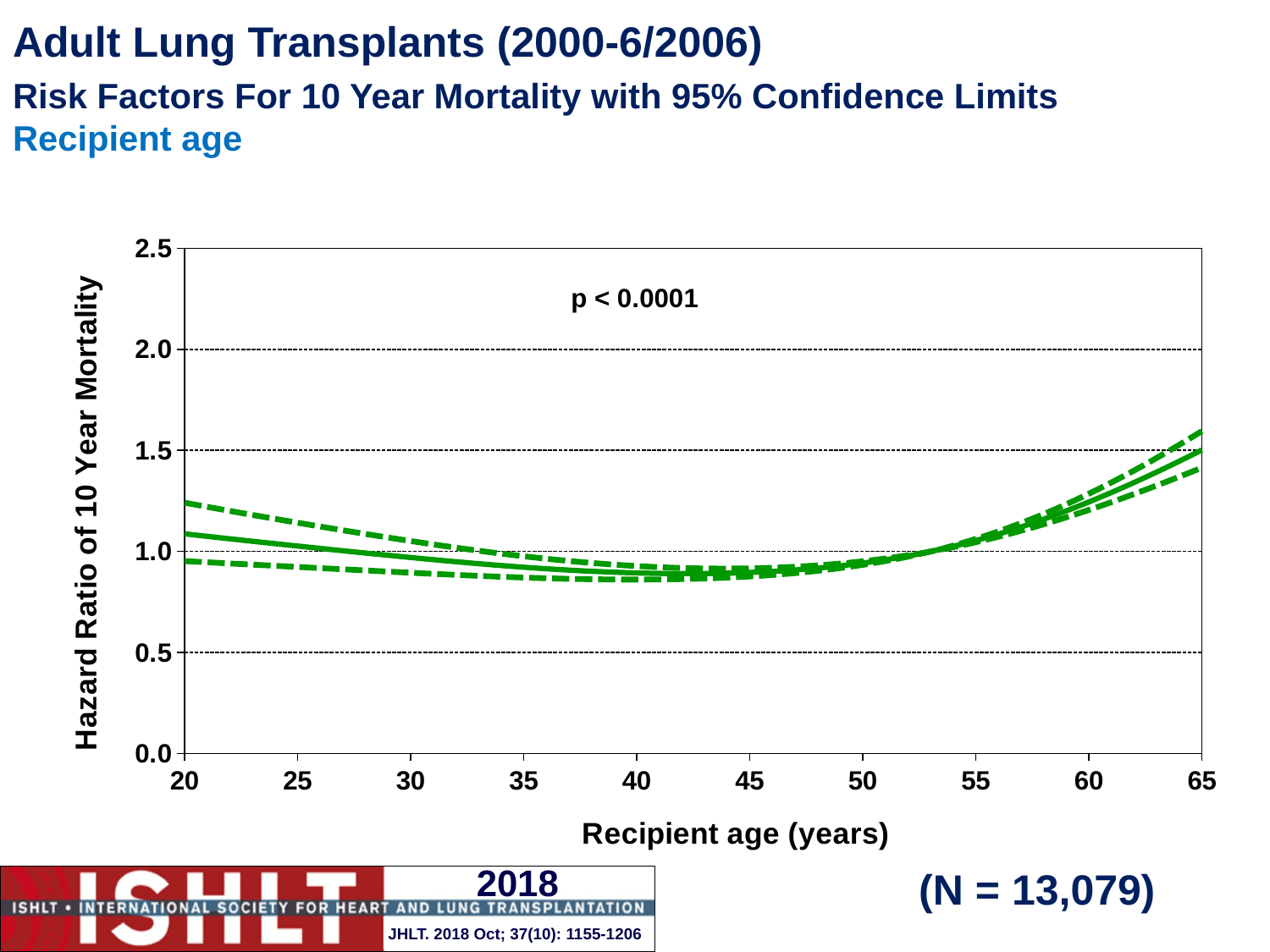
Is the hazard ratio (solid line) larger at recipient age 65 or at recipient age 20? 65 Does the hazard ratio (solid line) rise or fall as recipient age increases from 50 to 65? rise What is the label of the x axis? Recipient age (years) Is the hazard ratio (solid line) at recipient age 40 greater or less than 1.0? less Which recipient age shown on the x axis has the highest hazard ratio on the solid line? 65 What p-value is printed on the chart? p < 0.0001 Is the hazard ratio (solid line) at recipient age 45 greater or less than 0.5? greater Does the hazard ratio (solid line) rise or fall as recipient age increases from 20 to 40? fall What kind of chart is shown on the slide? line chart Is the hazard ratio (solid line) at recipient age 65 greater or less than 2.0? less How many lines are plotted on the chart? 3